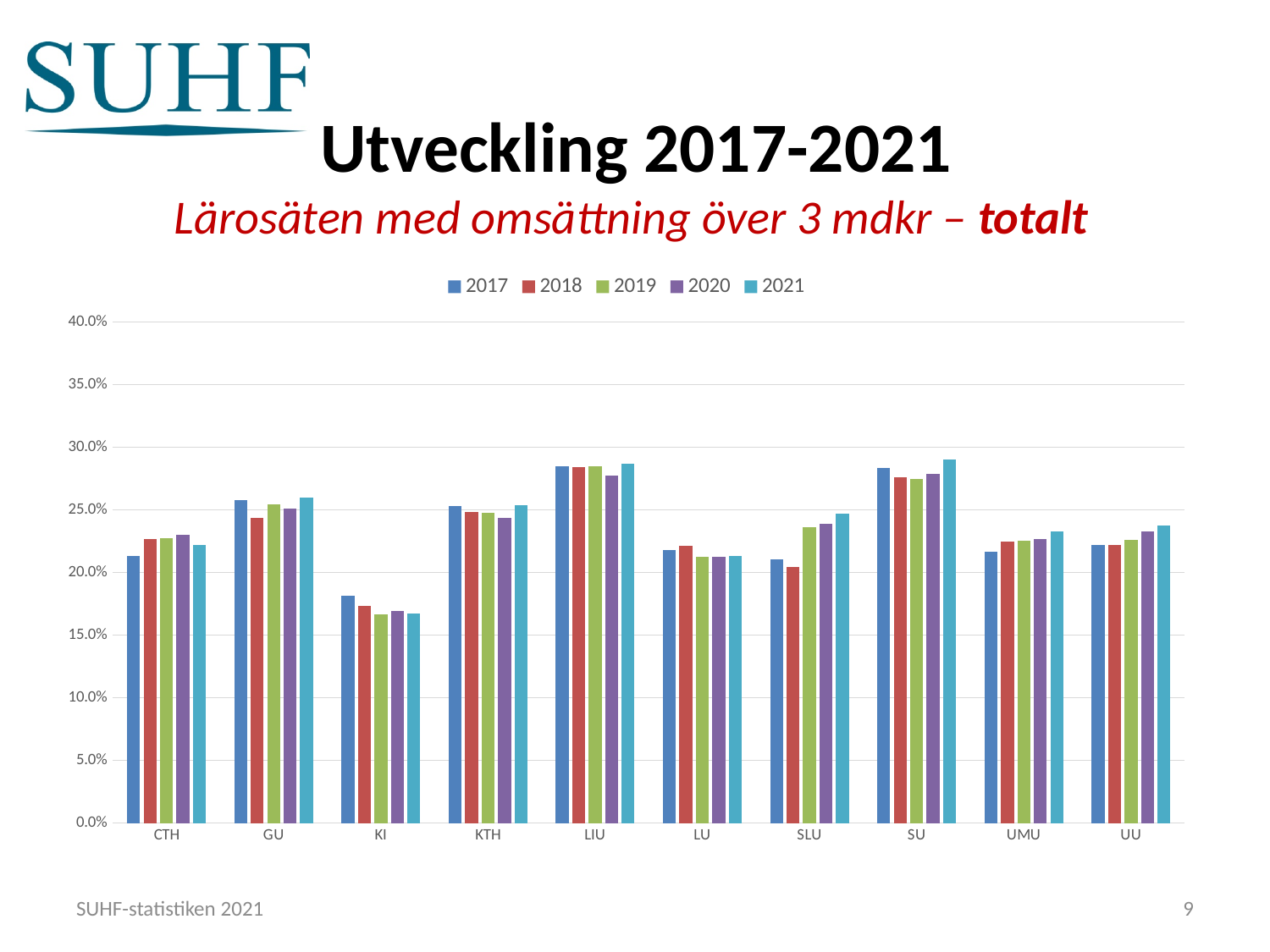
Do the values for SLU rise or fall from 2018 to 2021? rise What is the title of the slide's chart section in red? Lärosäten med omsättning över 3 mdkr – totalt Is the 2021 value for LIU greater or less than 25.0%? greater How many institutions (categories) are shown on the x axis? 10 Which is larger for SLU: the 2018 value or the 2021 value? 2021 Is the 2021 value for SU greater or less than 30.0%? less Which institution has the lowest values across all years? KI Is the 2020 value for KTH greater or less than 25.0%? less How many series does the legend list? 5 Which is larger for KI: the 2017 value or the 2019 value? 2017 What kind of chart is shown on the slide? bar chart